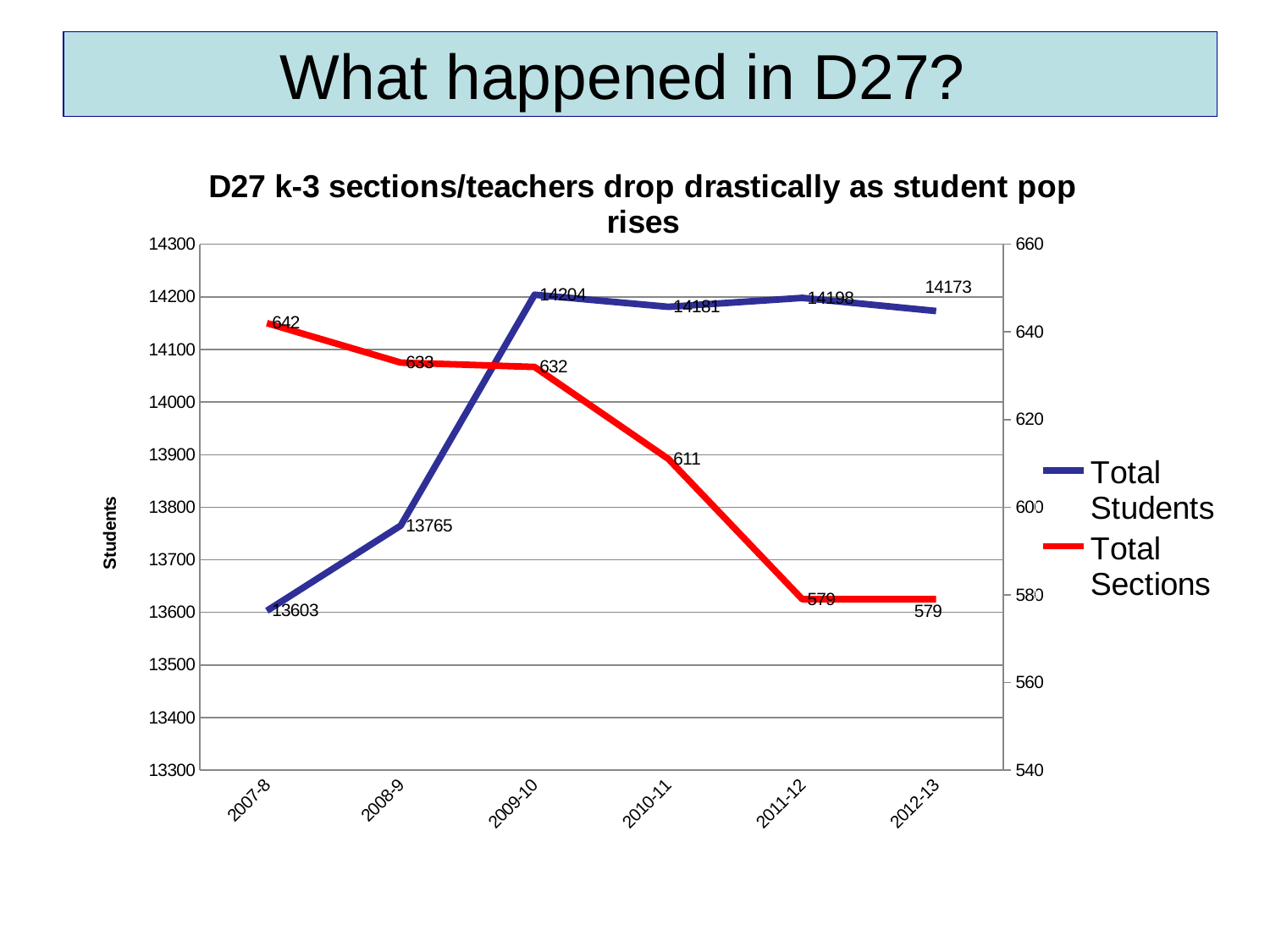
Does Total Sections generally rise or fall from 2007-8 to 2012-13? fall What is the value for Total Students in 2012-13? 14173 What is the difference between Total Students in 2009-10 and 2008-9? 439 In which school year is Total Sections highest? 2007-8 How many school years are plotted along the x axis? 6 What kind of chart is shown on the slide? line chart What is the title of the chart? D27 k-3 sections/teachers drop drastically as student pop rises What is the value for Total Students in 2007-8? 13603 What is the difference between Total Sections in 2007-8 and 2012-13? 63 How many series does the legend list? 2 In which school year is Total Students highest? 2009-10 What is the value for Total Sections in 2010-11? 611